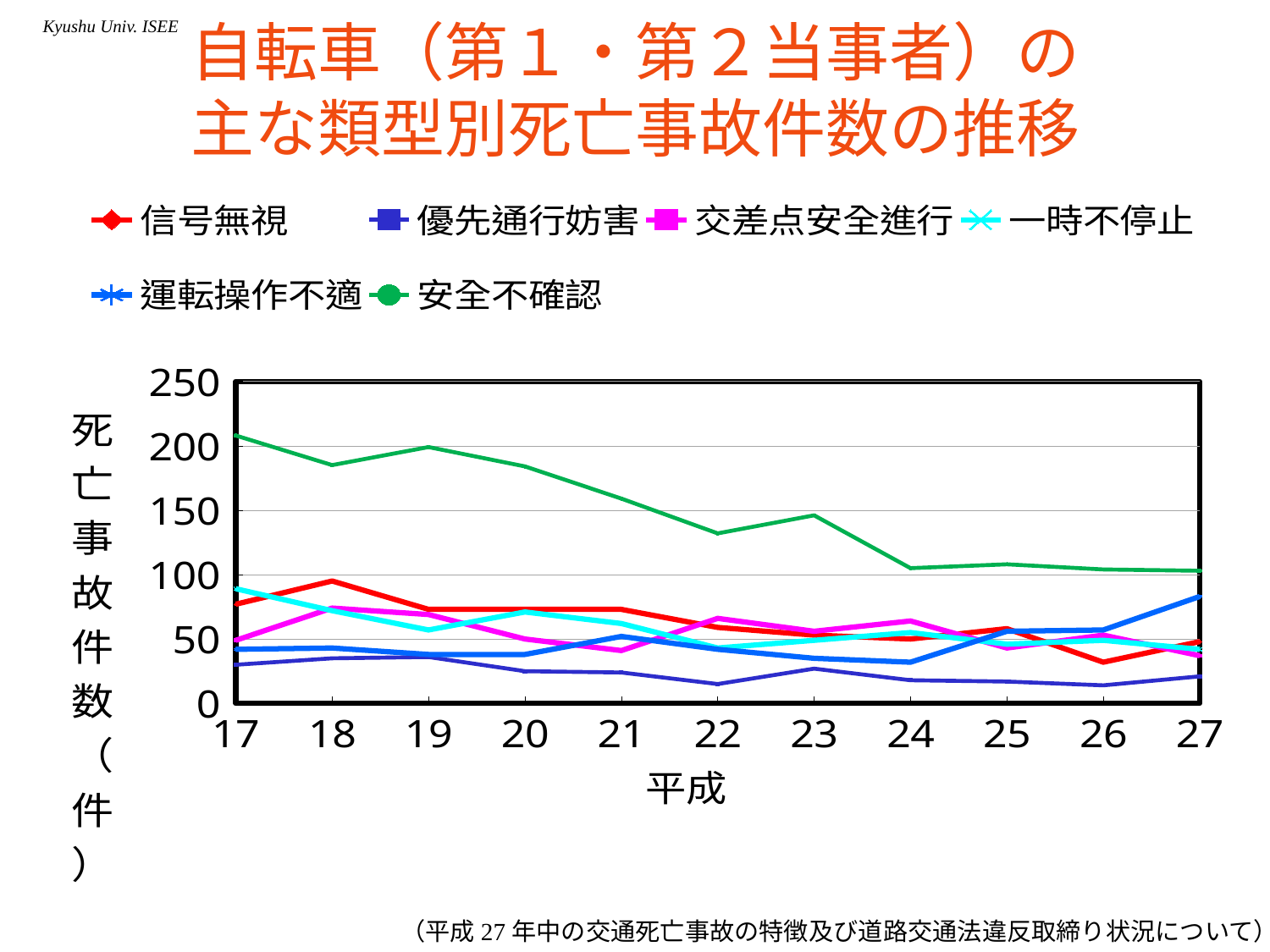
In 平成17, which is larger: the value for 安全不確認 or the value for 信号無視? 安全不確認 What is the title of the x axis? 平成 Which series has the lowest value in 平成27? 優先通行妨害 How many series does the legend list? 6 Does the value for 運転操作不適 rise or fall from 平成17 to 平成27? rise How many years (points) are plotted along the x axis? 11 What kind of chart is shown on the slide? line chart Which series has the highest value in 平成17? 安全不確認 Does the value for 安全不確認 rise or fall from 平成17 to 平成27? fall Is the value for 安全不確認 in 平成22 greater or less than 150? less Is the value for 優先通行妨害 in 平成22 greater or less than 50? less Is the value for 安全不確認 in 平成17 greater or less than 200? greater